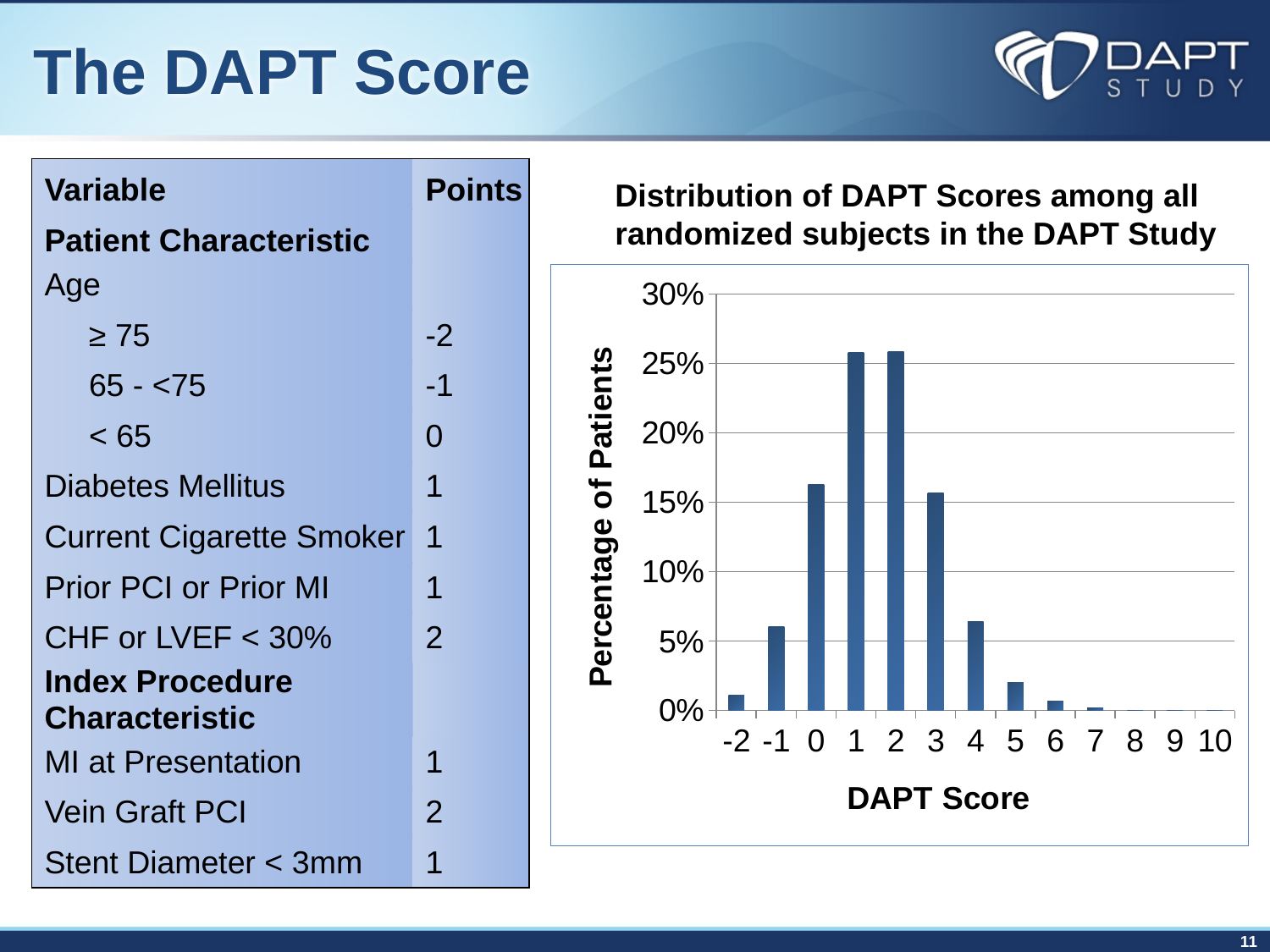
Is the percentage of patients with a DAPT score of 3 greater or less than 10%? greater Which has a higher percentage of patients, a DAPT score of 0 or a DAPT score of 4? 0 Which has a higher percentage of patients, a DAPT score of -1 or a DAPT score of 5? -1 Do the bars rise or fall as the DAPT score increases from 2 to 7? fall What is the title of the chart? Distribution of DAPT Scores among all randomized subjects in the DAPT Study Is the percentage of patients with a DAPT score of 1 greater or less than 20%? greater What is the label of the y axis of the chart? Percentage of Patients Is the percentage of patients with a DAPT score of 0 greater or less than 20%? less How many DAPT score categories are shown on the x axis of the chart? 13 What kind of chart is shown on the slide? bar chart